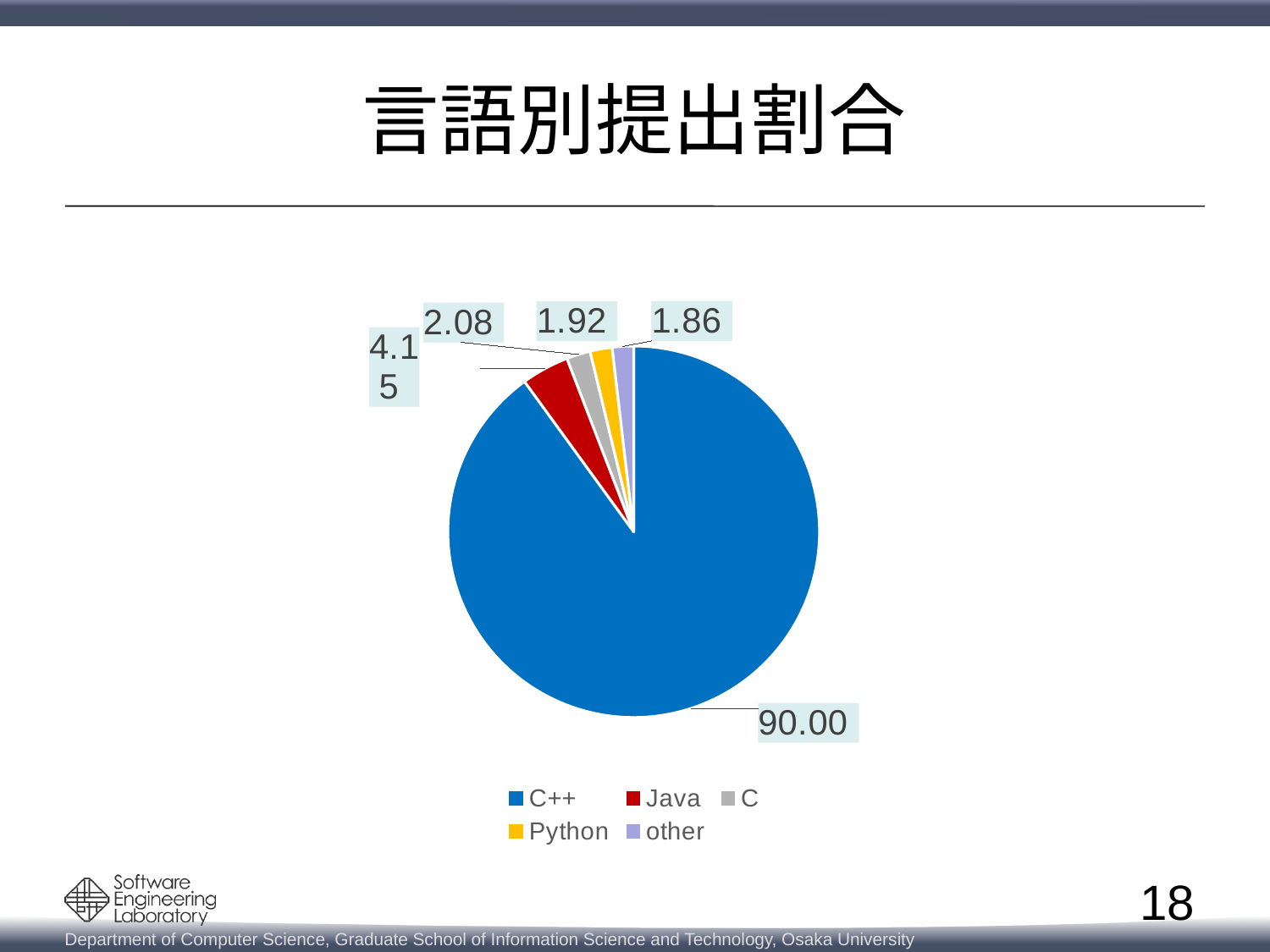
What type of chart is shown on the slide? pie chart What is the value shown for Python in the pie chart? 1.92 What colour is the C++ slice in the pie chart? blue What is the value shown for the 'other' slice in the pie chart? 1.86 Which language has the largest slice of the pie chart? C++ What is the value shown for Java in the pie chart? 4.15 What is the value shown for C in the pie chart? 2.08 Which category has the smallest slice of the pie chart? other What is the value shown for C++ in the pie chart? 90.00 How many categories does the legend of the pie chart list? 5 Which has a larger value, Python or other? Python What is the difference between the values for C++ and Java? 85.85